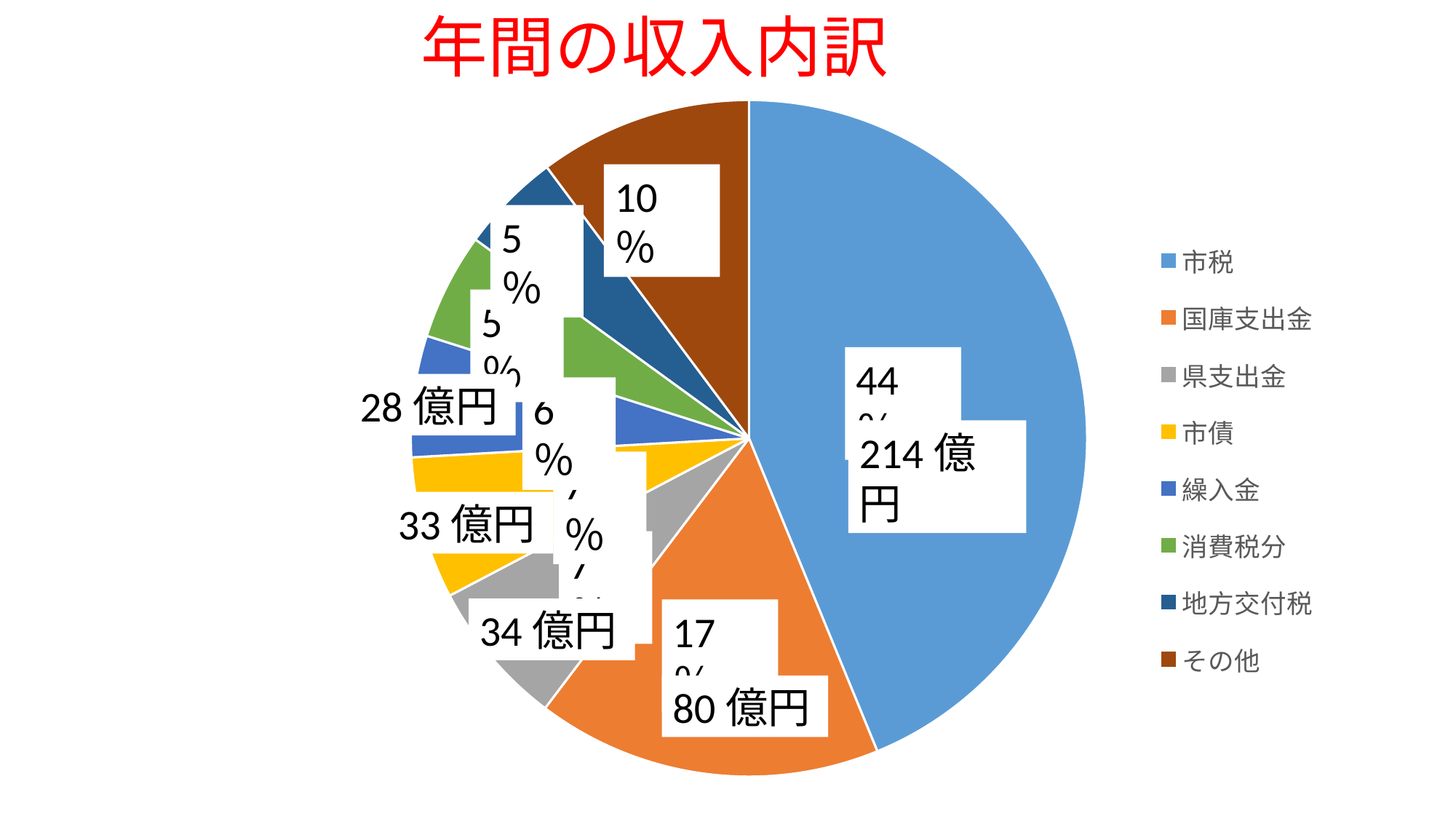
What is the title of the chart? 年間の収入内訳 What share of the pie does 市税 represent? 44% How many categories does the legend list? 8 What share of the pie does その他 represent? 10% What is the amount shown for 国庫支出金? 80 億円 What is the amount shown for 繰入金? 28 億円 Which category has the largest slice of the pie? 市税 What is the amount shown for 市税? 214 億円 What share of the pie does 国庫支出金 represent? 17% What is the amount shown for 県支出金? 34 億円 What is the difference between the amounts for 市税 and 国庫支出金? 134 億円 What kind of chart is shown on the slide? pie chart